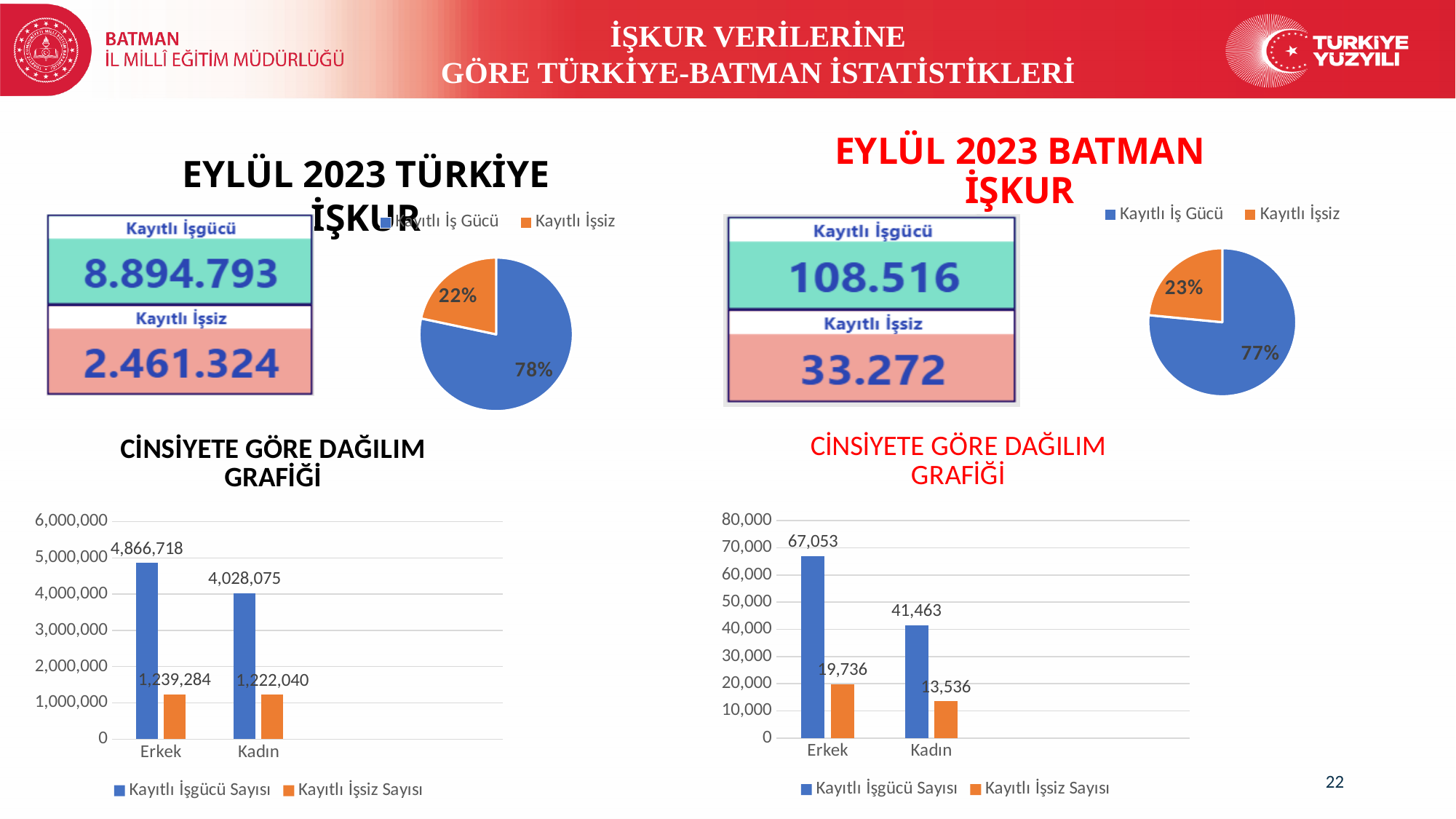
In the right CİNSİYETE GÖRE DAĞILIM GRAFİĞİ bar chart (Batman), what is the difference between the Kayıtlı İşsiz Sayısı for Erkek and for Kadın? 6,200 What kind of chart is the EYLÜL 2023 BATMAN İŞKUR chart? Pie chart What kind of chart is the right CİNSİYETE GÖRE DAĞILIM GRAFİĞİ chart (Batman)? Bar chart In the right CİNSİYETE GÖRE DAĞILIM GRAFİĞİ bar chart (Batman), what is the Kayıtlı İşsiz Sayısı for Erkek? 19,736 In the left CİNSİYETE GÖRE DAĞILIM GRAFİĞİ bar chart (Türkiye), what is the Kayıtlı İşsiz Sayısı for Kadın? 1,222,040 In the left CİNSİYETE GÖRE DAĞILIM GRAFİĞİ bar chart (Türkiye), what is the difference between the Kayıtlı İşgücü Sayısı for Erkek and for Kadın? 838,643 In the EYLÜL 2023 BATMAN İŞKUR pie chart, what share does Kayıtlı İş Gücü have? 77% In the right CİNSİYETE GÖRE DAĞILIM GRAFİĞİ bar chart (Batman), which category has the highest Kayıtlı İşgücü Sayısı? Erkek In the right CİNSİYETE GÖRE DAĞILIM GRAFİĞİ bar chart (Batman), what is the Kayıtlı İşgücü Sayısı for Kadın? 41,463 In the left CİNSİYETE GÖRE DAĞILIM GRAFİĞİ bar chart (Türkiye), what is the Kayıtlı İşgücü Sayısı for Erkek? 4,866,718 In the EYLÜL 2023 TÜRKİYE İŞKUR pie chart, what share does Kayıtlı İşsiz have? 22% How many series does the legend of the left CİNSİYETE GÖRE DAĞILIM GRAFİĞİ bar chart list? 2